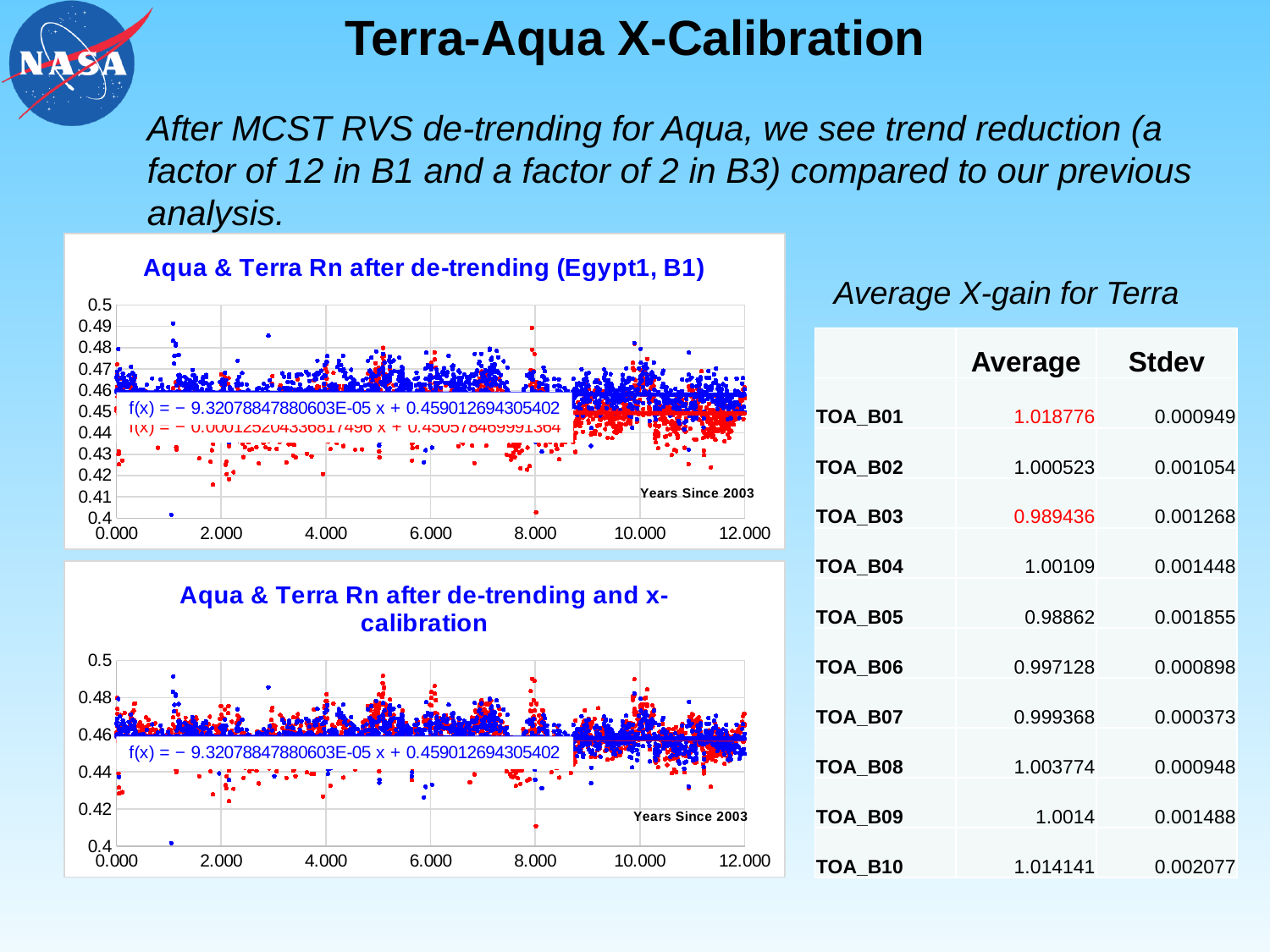
In the bottom chart, what is the highest tick value shown on the x axis? 12.000 In the top chart, what is the lowest tick value shown on the y axis? 0.4 According to the fitted line equation printed in the bottom chart, do the values rise or fall as years since 2003 increase? fall What is the title of the bottom chart on the slide? Aqua & Terra Rn after de-trending and x-calibration In the bottom chart, what is the highest tick value shown on the y axis? 0.5 In the bottom chart, what is the intercept of the fitted line equation printed on the plot? 0.459012694305402 How many tick labels are shown on the y axis of the bottom chart? 6 What kind of chart is the top chart titled 'Aqua & Terra Rn after de-trending (Egypt1, B1)'? scatter chart How many tick labels are shown on the y axis of the top chart? 11 How many tick labels are shown on the x axis of the top chart? 7 In the top chart, what is the label of the x axis? Years Since 2003 In the bottom chart, what fitted line equation is printed on the plot? f(x) = − 9.32078847880603E-05 x + 0.459012694305402